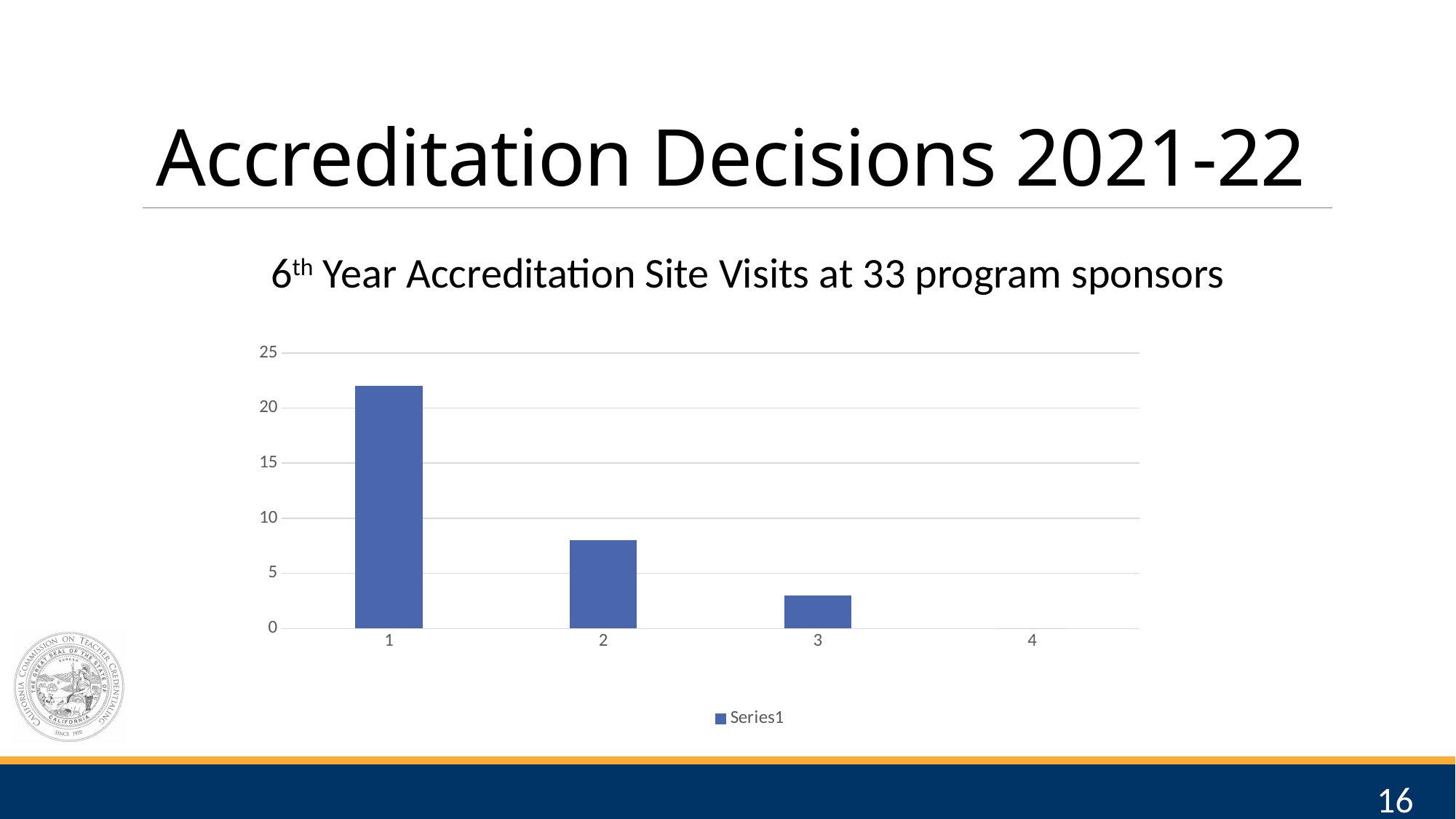
Is the value for category 2 greater or less than 10? less Which category has the lowest value in the chart? 4 How many categories are shown on the x axis of the chart? 4 Is the value for category 2 greater or less than 5? greater How many series does the chart legend list? 1 What kind of chart is shown on the slide? Bar chart What is the name of the series listed in the chart legend? Series1 Is the value for category 1 greater or less than 20? greater Which category has the highest value in the chart? 1 Do the values rise or fall moving from category 1 to category 4 along the x axis? Fall Which is larger, the value for category 1 or the value for category 2? Category 1